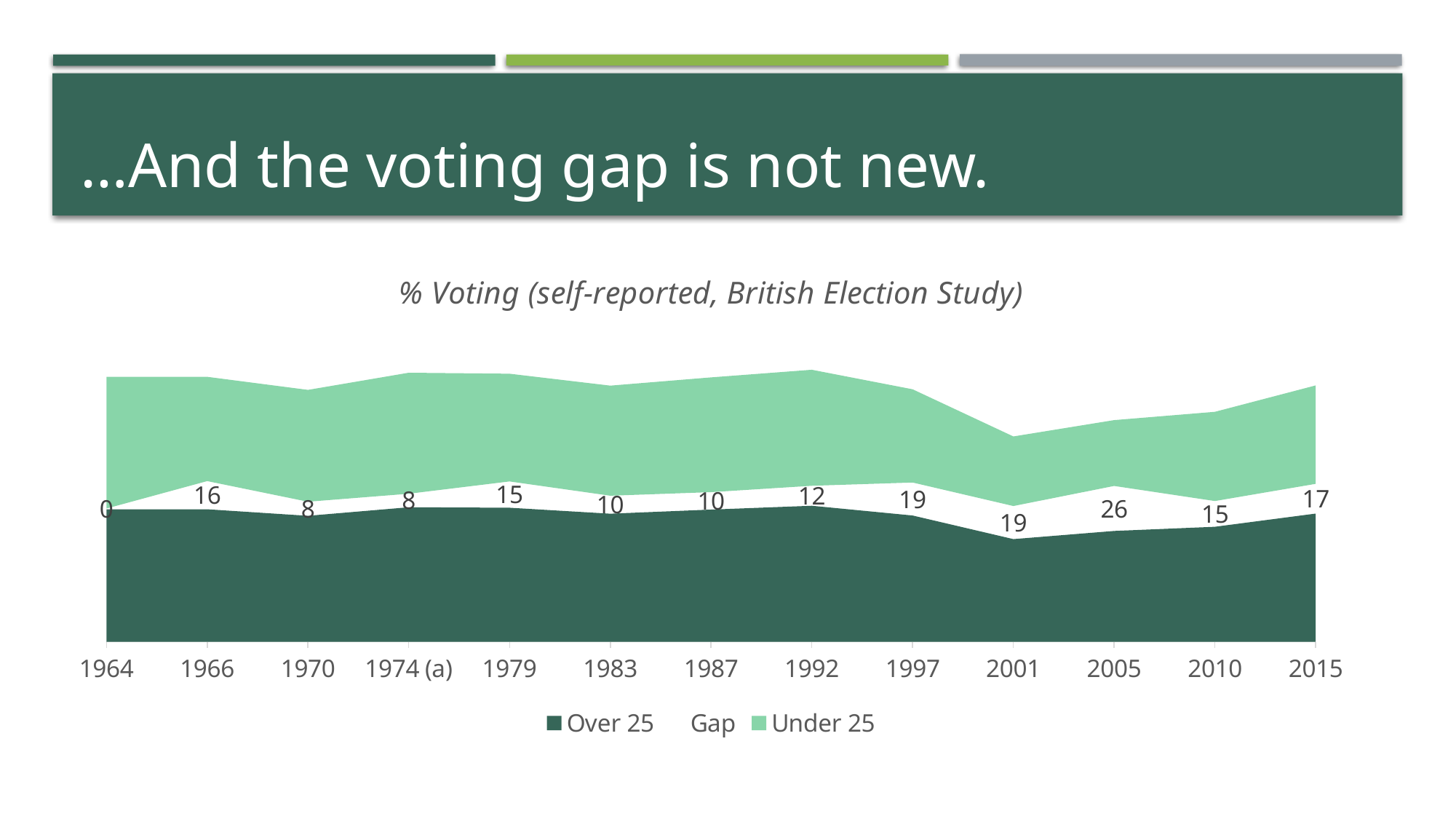
What is the Gap value for 1992? 12 How many years are shown on the x axis? 13 How many series does the legend list? 3 What is the title of the chart? % Voting (self-reported, British Election Study) What kind of chart is shown on the slide? Area chart In which year is the Gap value highest? 2005 What is the Gap value for 1966? 16 In which year is the Gap value lowest? 1964 Which year has the larger Gap value, 1966 or 1970? 1966 What is the Gap value for 2015? 17 What is the Gap value for 2005? 26 What is the difference between the Gap values for 2005 and 2010? 11